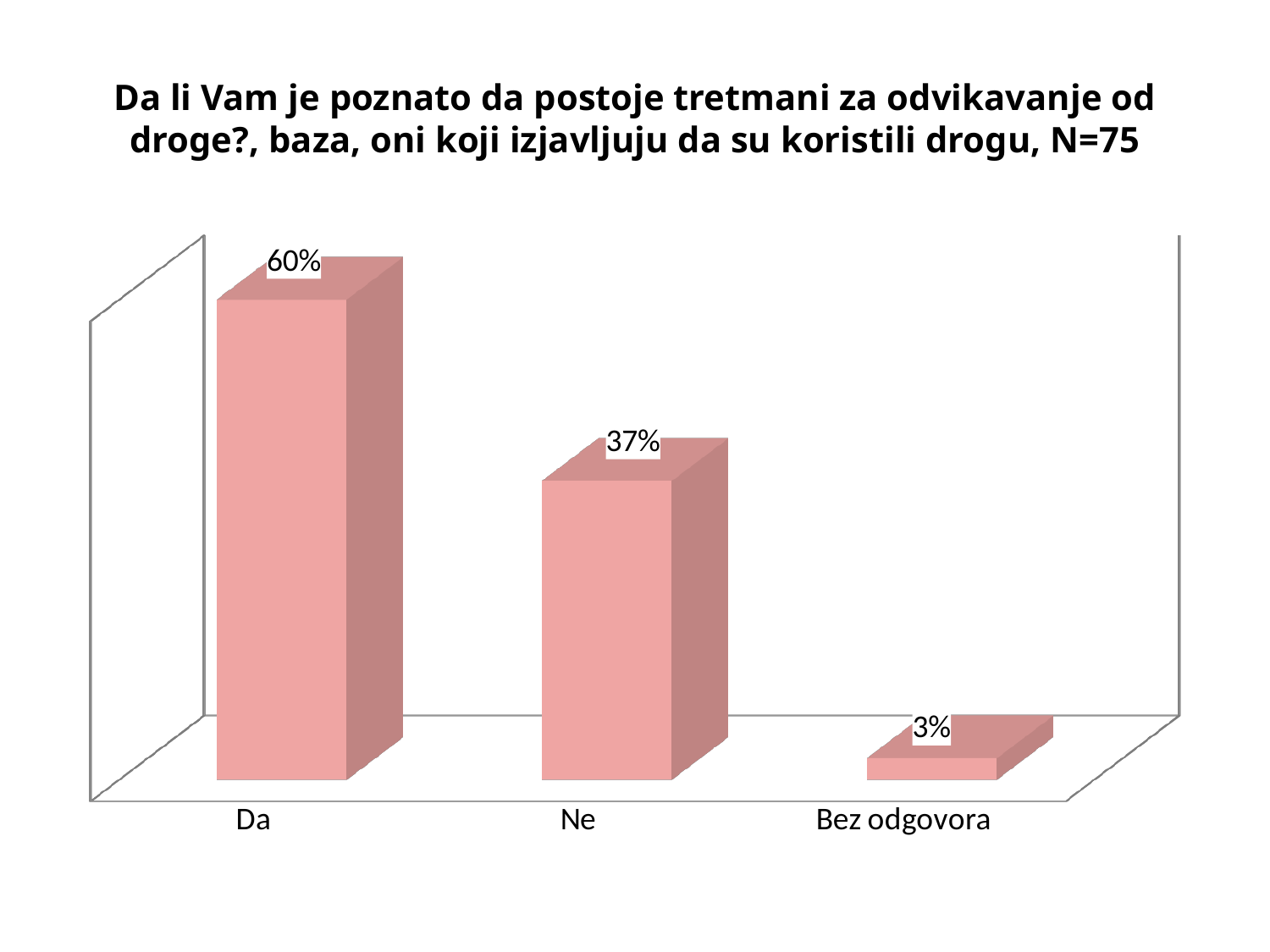
How many categories are shown on the x axis? 3 What is the value for "Da"? 60% Do the values rise or fall from left to right along the x axis? fall What is the value for "Ne"? 37% What kind of chart is shown on the slide? bar chart What is the value for "Bez odgovora"? 3% Which category has the lowest value? Bez odgovora What is the difference between the values for "Ne" and "Bez odgovora"? 34% Which is larger, the value for "Da" or the value for "Ne"? Da What sample size (N) is stated in the chart title? N=75 Which category has the highest value? Da What is the difference between the values for "Da" and "Ne"? 23%